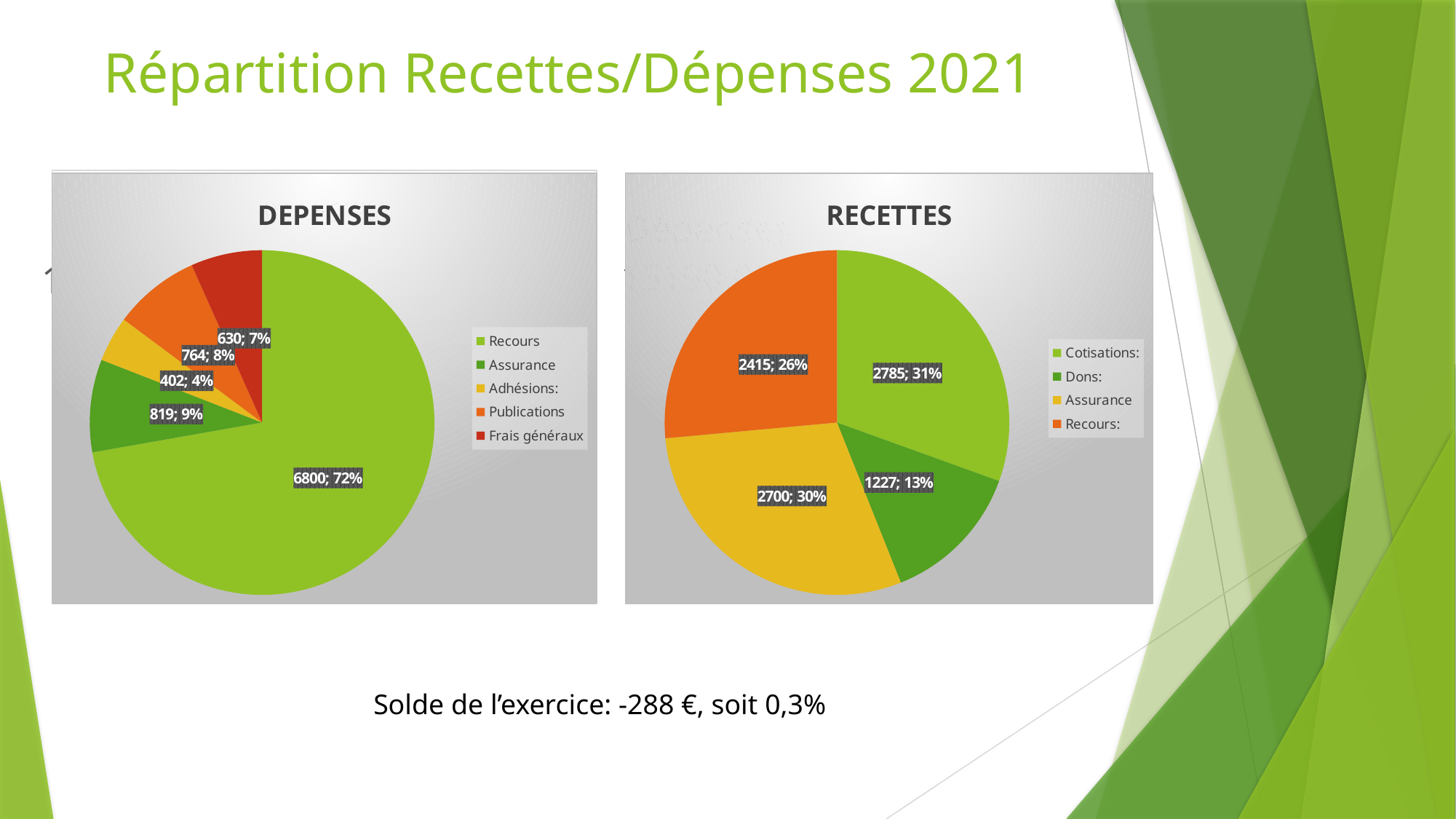
What type of chart is the RECETTES chart? Pie chart In the DEPENSES chart, what is the difference between Publications and Frais généraux? 134 In the RECETTES chart, which is larger, Cotisations or Assurance? Cotisations: In the DEPENSES chart, which category is the smallest? Adhésions: In the RECETTES chart, what is the difference between Cotisations and Recours? 370 In the RECETTES chart, what is the value for Dons? 1227 In the RECETTES chart, which category is the smallest? Dons: In the DEPENSES chart, what is the value for Recours? 6800 In the DEPENSES chart, how many categories are shown? 5 In the DEPENSES chart, which category is the largest? Recours In the DEPENSES chart, what share of the pie does Assurance represent? 9% In the RECETTES chart, what share of the pie does Recours represent? 26%